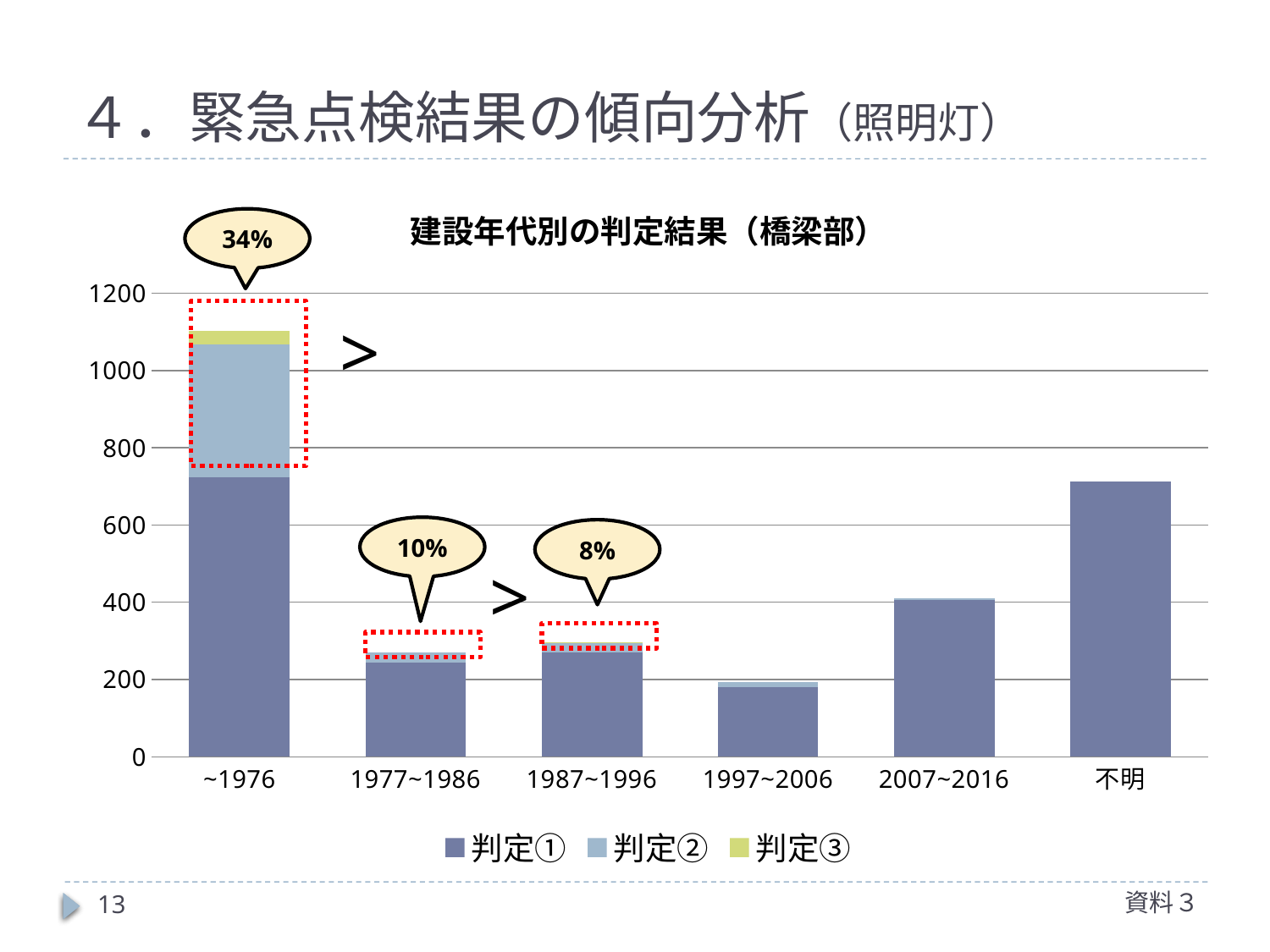
Is the value for 1977~1986 greater or less than 200? greater What percentage is shown in the callout above the ~1976 bar? 34% Is the value for 不明 greater or less than 800? less What type of chart is shown on the slide? bar chart Is the total for ~1976 greater or less than 1000? greater Which is larger, the bar for 2007~2016 or the bar for 1997~2006? 2007~2016 Which is larger, the bar for ~1976 or the bar for 不明? ~1976 Which category has the tallest stacked bar? ~1976 How many construction-period categories are shown on the x axis? 6 Which category has the shortest stacked bar? 1997~2006 How many series does the legend list? 3